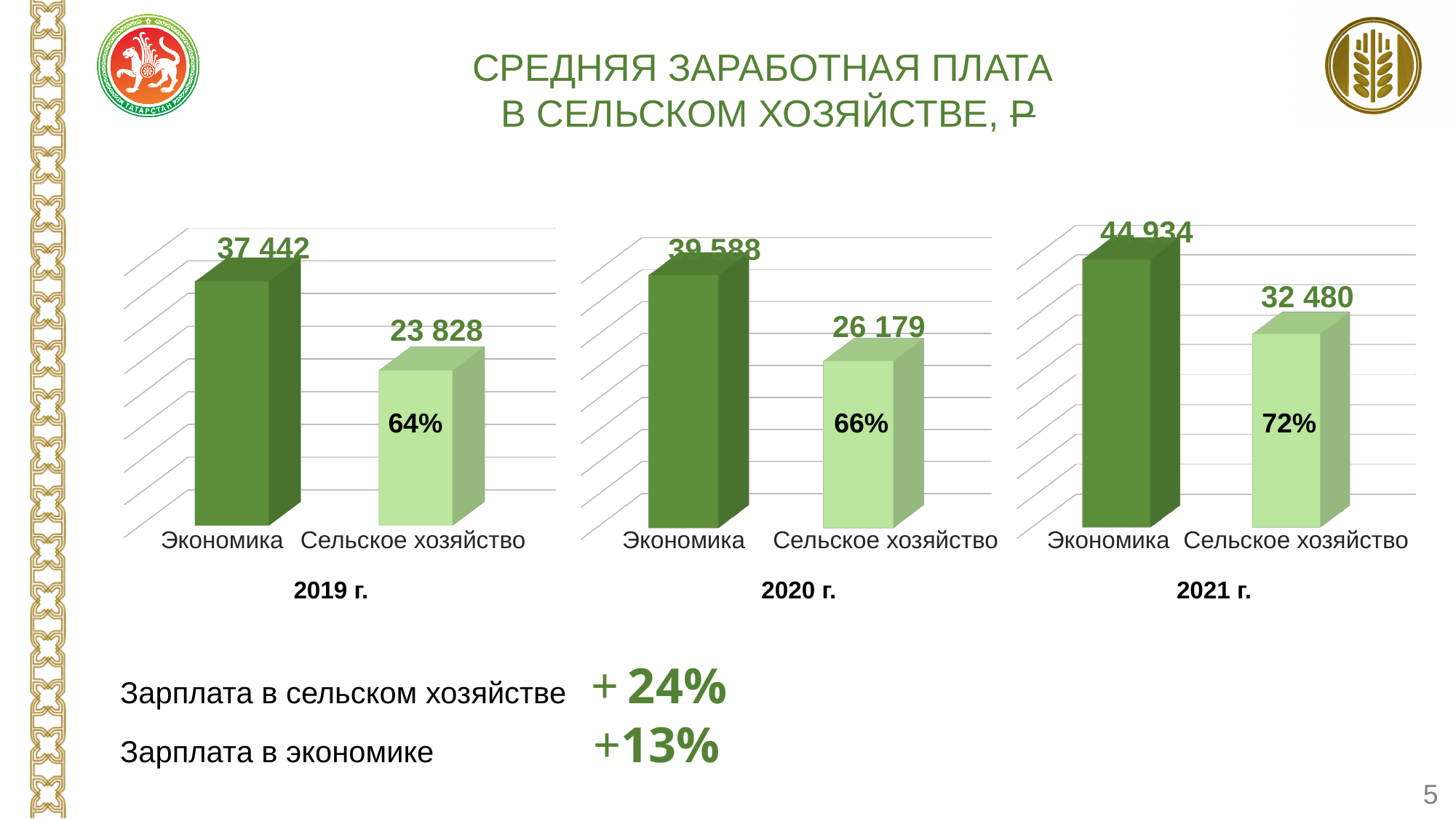
What type of chart is used for the 2019 г. data? Bar chart In the 2021 г. chart, what is the difference between the Экономика and Сельское хозяйство values? 12 454 In the 2019 г. chart, what is the value for Сельское хозяйство? 23 828 What percentage label is printed on the Сельское хозяйство bar in the 2021 г. chart? 72% In the 2021 г. chart, what is the value for Сельское хозяйство? 32 480 In the 2020 г. chart, what is the value for Сельское хозяйство? 26 179 How many bars are shown in the 2020 г. chart? 2 In the 2021 г. chart, which category has the lowest value? Сельское хозяйство In the 2020 г. chart, which category has the higher value? Экономика In the 2019 г. chart, what is the difference between the Экономика and Сельское хозяйство values? 13 614 In the 2021 г. chart, what is the value for Экономика? 44 934 In the 2019 г. chart, what is the value for Экономика? 37 442